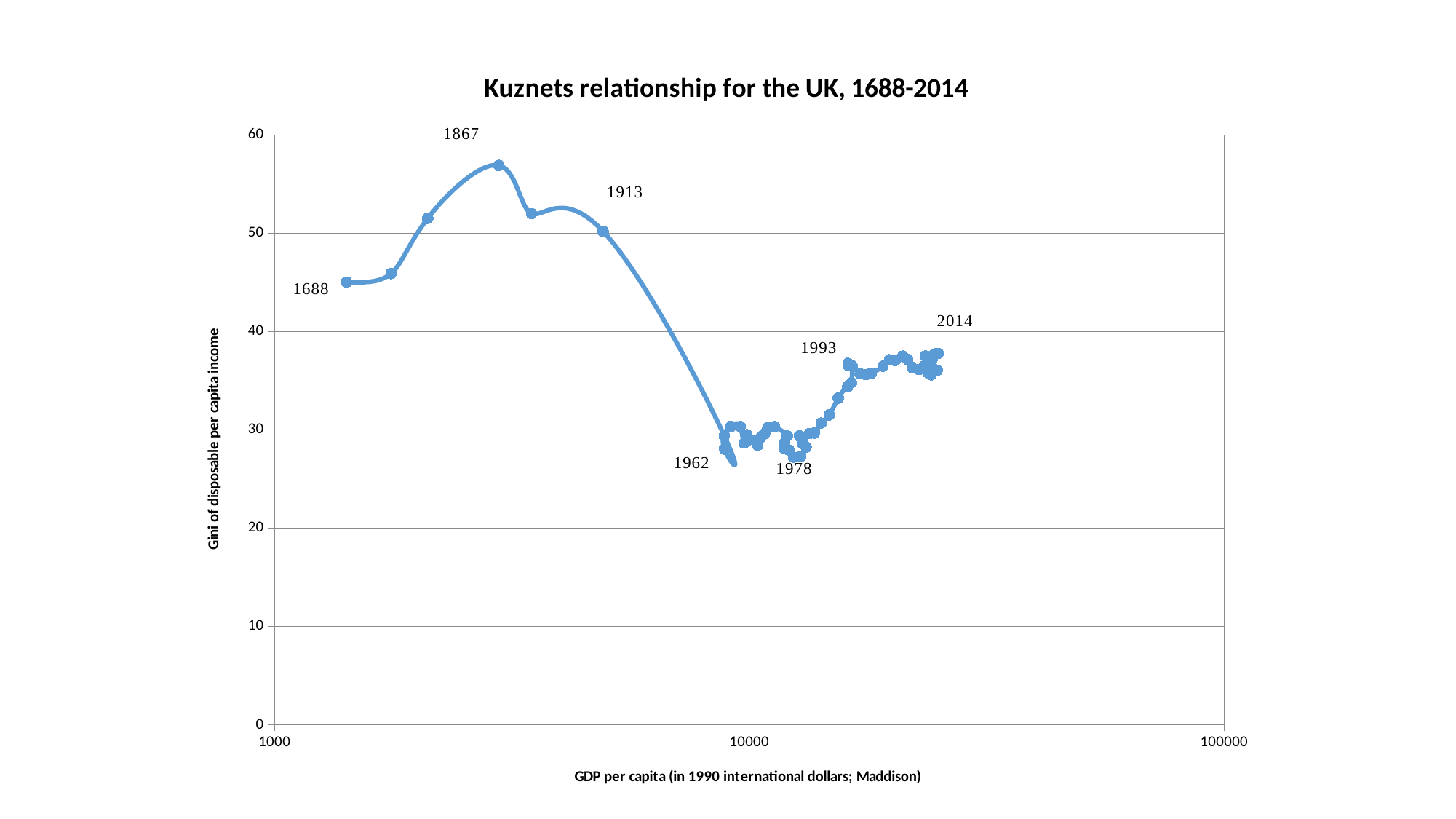
Which has the higher Gini value, 1688 or 1867? 1867 Does the Gini value rise or fall between 1867 and 1962? fall Which has the higher Gini value, 1962 or 2014? 2014 What is the title of the chart? Kuznets relationship for the UK, 1688-2014 Is the Gini value for 1962 greater or less than 30? less What kind of chart is shown on the slide? Line chart (scatter with smoothed line) Which labelled year has the highest Gini of disposable per capita income? 1867 Is the Gini value for 2014 greater or less than 40? less What is the label of the horizontal axis? GDP per capita (in 1990 international dollars; Maddison) Is the GDP per capita for 1962 greater or less than 10000? less